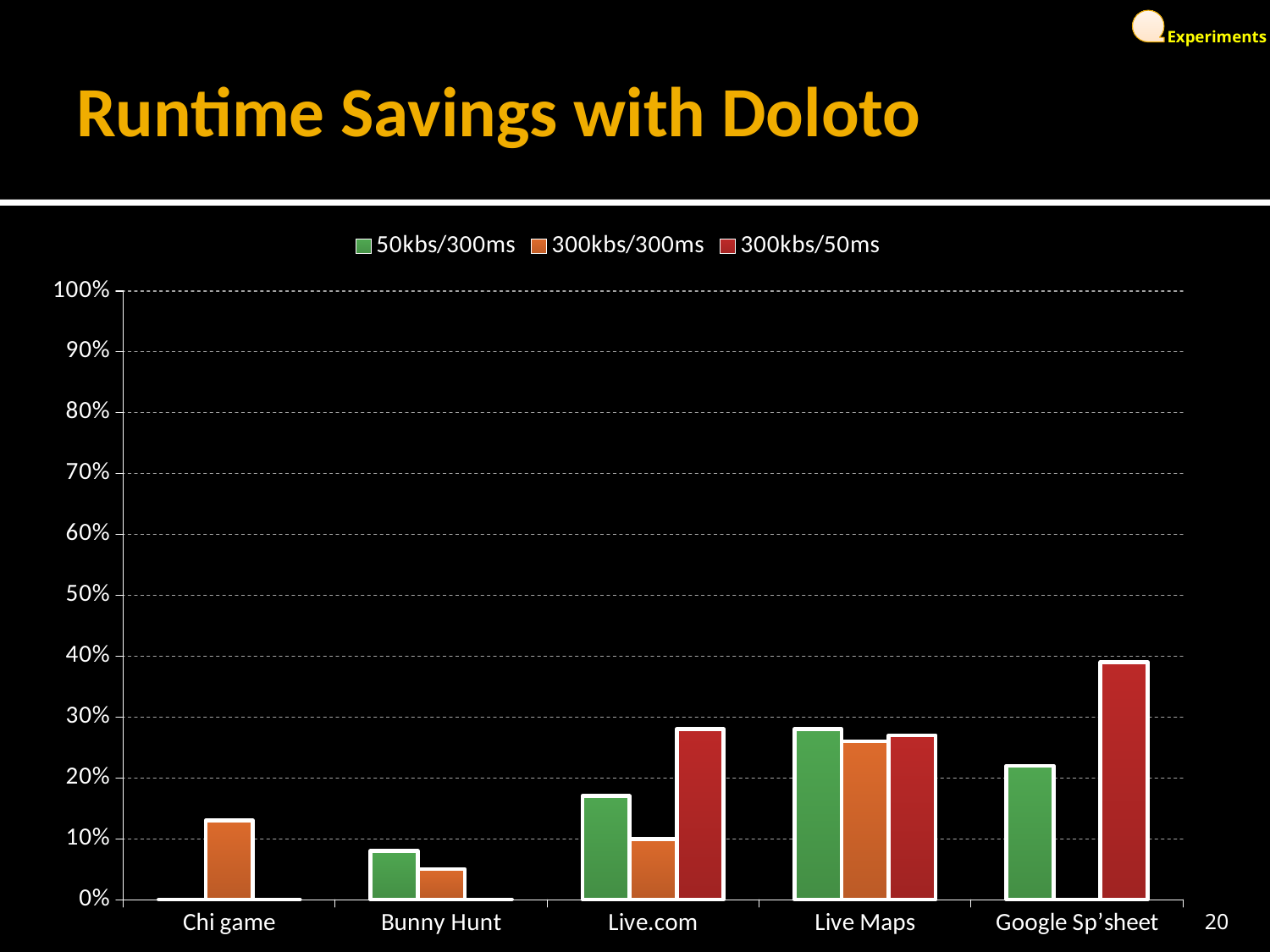
For Live.com, which is larger: the 300kbs/50ms value or the 300kbs/300ms value? 300kbs/50ms What kind of chart is shown on the slide? bar chart Which category has the highest bar for the 300kbs/50ms series? Google Sp'sheet For Bunny Hunt, which is larger: the 50kbs/300ms value or the 300kbs/300ms value? 50kbs/300ms How many series does the legend list? 3 Which category has the highest bar for the 50kbs/300ms series? Live Maps Is the value for Google Sp'sheet in the 300kbs/50ms series greater or less than 30%? greater What is the title of the slide containing the chart? Runtime Savings with Doloto Is the value for Chi game in the 300kbs/300ms series greater or less than 20%? less Which category has the highest bar for the 300kbs/300ms series? Live Maps How many categories are shown on the x axis? 5 Is the value for Live.com in the 50kbs/300ms series greater or less than 10%? greater